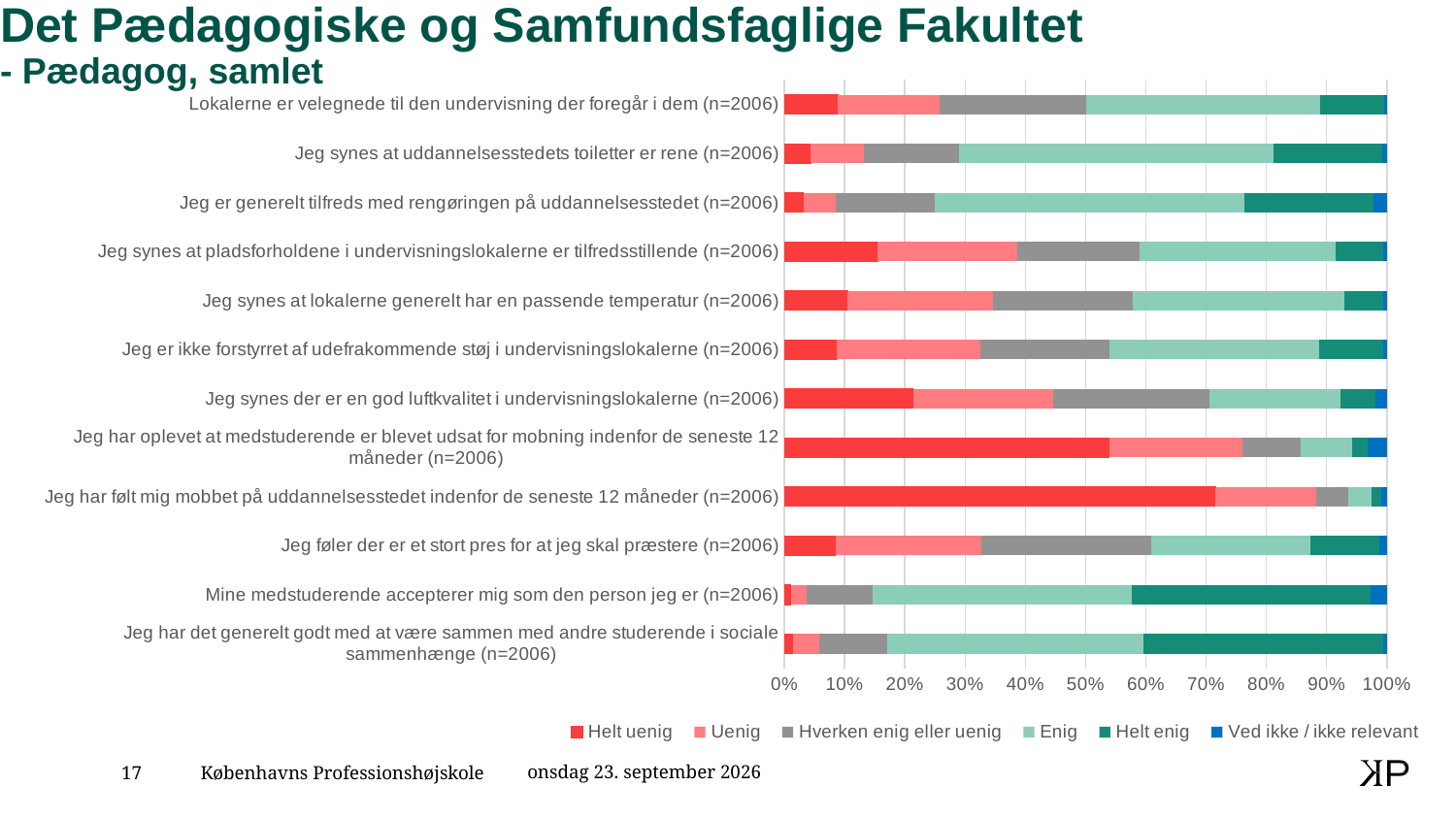
Which has the larger 'Helt uenig' share: 'Jeg synes der er en god luftkvalitet i undervisningslokalerne (n=2006)' or 'Jeg synes at pladsforholdene i undervisningslokalerne er tilfredsstillende (n=2006)'? Jeg synes der er en god luftkvalitet i undervisningslokalerne (n=2006) What is the first entry in the chart legend? Helt uenig What is the highest value shown on the x axis of the chart? 100% Is the 'Helt uenig' value for 'Jeg har det generelt godt med at være sammen med andre studerende i sociale sammenhænge (n=2006)' greater or less than 10%? less Which has the larger 'Helt enig' share: 'Jeg synes at uddannelsesstedets toiletter er rene (n=2006)' or 'Lokalerne er velegnede til den undervisning der foregår i dem (n=2006)'? Jeg synes at uddannelsesstedets toiletter er rene (n=2006) What kind of chart is shown on the slide? Stacked bar chart Is the 'Helt uenig' value for 'Jeg har følt mig mobbet på uddannelsesstedet indenfor de seneste 12 måneder (n=2006)' greater or less than 60%? greater Which statement has the largest 'Helt uenig' segment? Jeg har følt mig mobbet på uddannelsesstedet indenfor de seneste 12 måneder (n=2006) How many series does the chart legend list? 6 How many statements (categories) are plotted in the chart? 12 Is the 'Helt uenig' value for 'Jeg synes der er en god luftkvalitet i undervisningslokalerne (n=2006)' greater or less than 30%? less